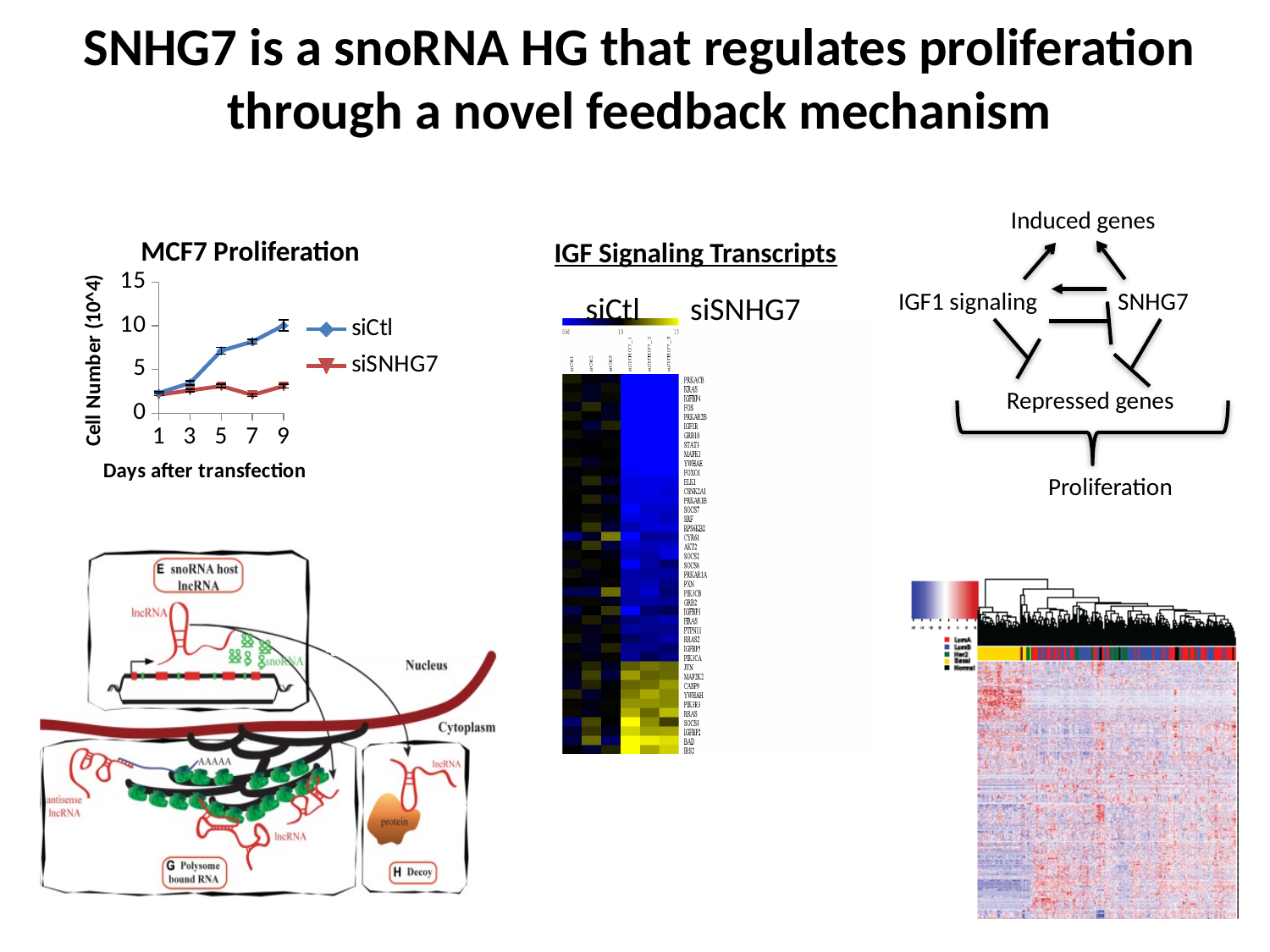
In the MCF7 Proliferation chart, which series has the higher cell number at day 9? siCtl In the MCF7 Proliferation chart, is the siCtl value at day 9 greater or less than 5? greater In the MCF7 Proliferation chart, is the siCtl value at day 5 greater or less than 5? greater How many series does the legend of the MCF7 Proliferation chart list? 2 What is the y-axis label of the MCF7 Proliferation chart? Cell Number (10^4) What is the x-axis label of the MCF7 Proliferation chart? Days after transfection In the MCF7 Proliferation chart, which series has the higher cell number at day 7? siCtl In the MCF7 Proliferation chart, does the siCtl series rise or fall from day 1 to day 9? rise In the MCF7 Proliferation chart, at which day does the siCtl series reach its highest value? 9 How many time points are plotted along the x axis of the MCF7 Proliferation chart? 5 What kind of chart is the MCF7 Proliferation chart? line chart In the MCF7 Proliferation chart, is the siSNHG7 value at day 9 greater or less than 5? less